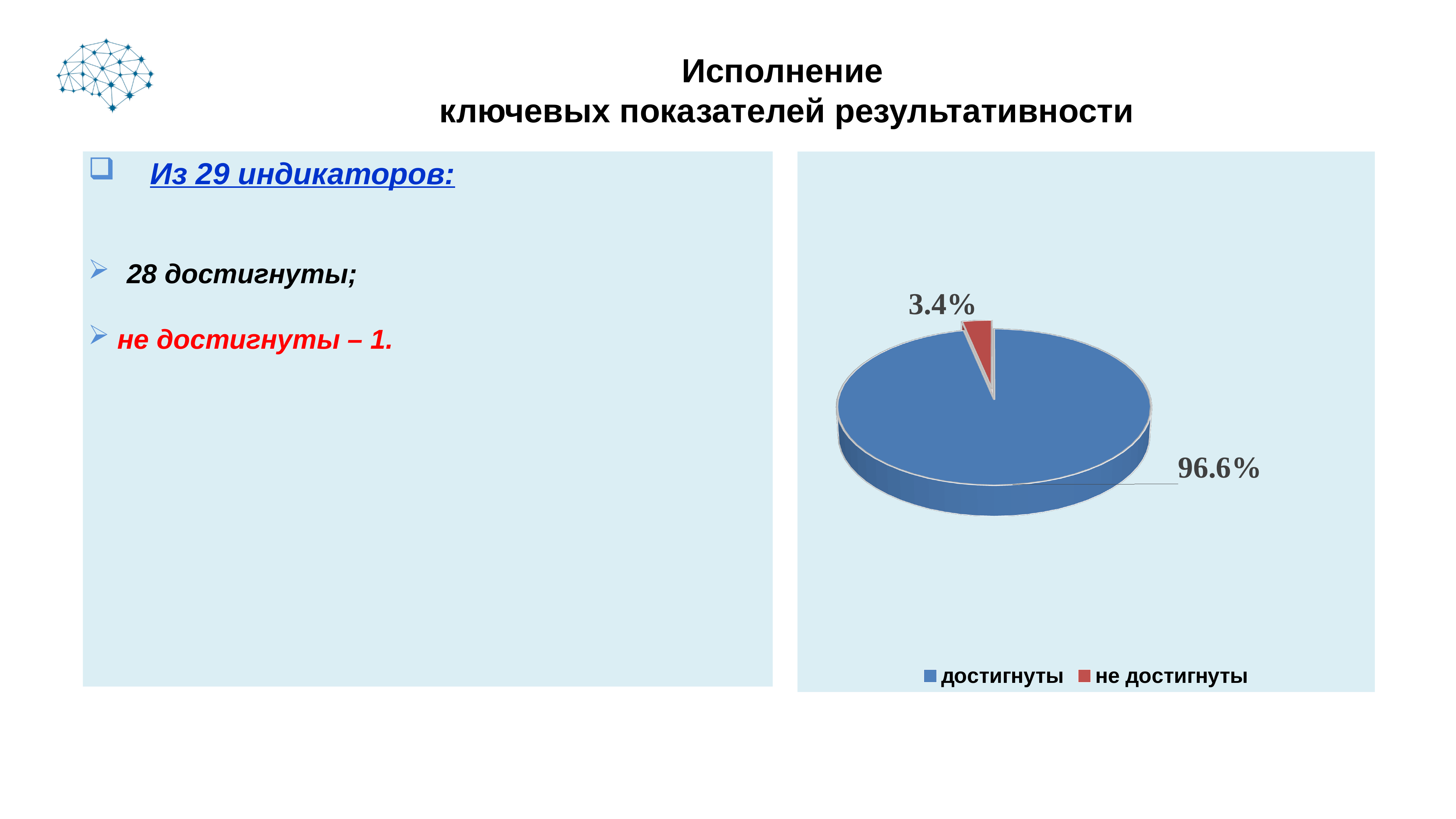
What is the difference in percentage points between the "достигнуты" and "не достигнуты" slices? 93.2 What colour is the "достигнуты" slice in the pie chart? blue Which slice of the pie is the smallest? не достигнуты Which is larger, the "достигнуты" slice or the "не достигнуты" slice? достигнуты How many slices does the pie chart have? 2 How many entries does the legend list? 2 What share of the pie does the "достигнуты" slice represent? 96.6% What colour is the "не достигнуты" slice in the pie chart? red What share of the pie does the "не достигнуты" slice represent? 3.4% What kind of chart is shown on the slide? pie chart Which slice of the pie is the largest? достигнуты